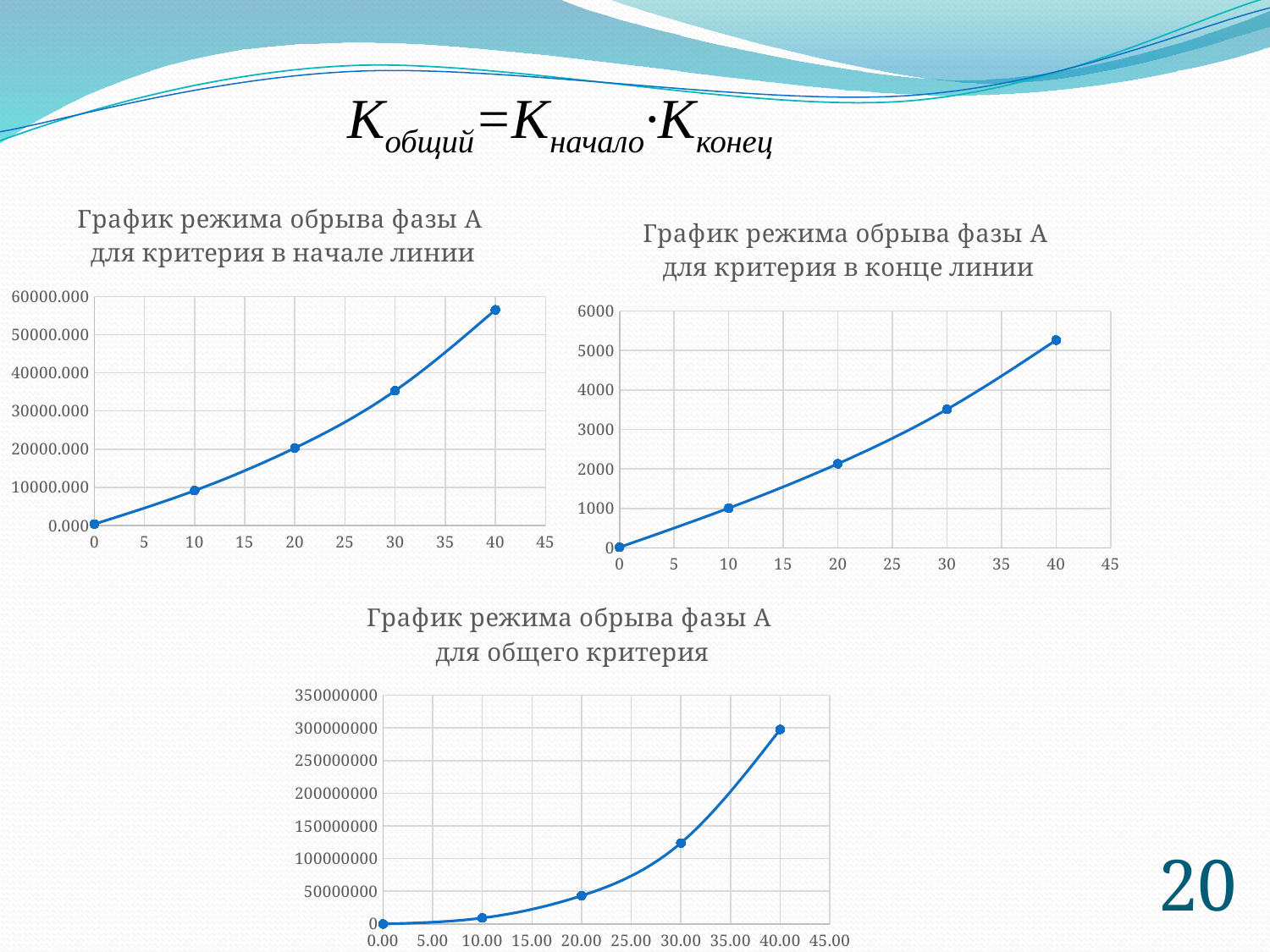
On the chart 'График режима обрыва фазы А для критерия в конце линии', is the value at x = 30 greater or less than 4000? less How many data points are plotted on the chart 'График режима обрыва фазы А для критерия в конце линии'? 5 How many data points are plotted on the chart 'График режима обрыва фазы А для критерия в начале линии'? 5 On the chart 'График режима обрыва фазы А для критерия в конце линии', is the value at x = 40 greater or less than 5000? greater On the chart 'График режима обрыва фазы А для критерия в начале линии', do the values rise or fall as x increases? rise On the chart 'График режима обрыва фазы А для критерия в начале линии', is the value at x = 40 greater or less than 50000.000? greater How many charts are shown on the slide? 3 What kind of chart is 'График режима обрыва фазы А для критерия в начале линии'? line chart On the chart 'График режима обрыва фазы А для общего критерия', which x value has the highest plotted value? 40.00